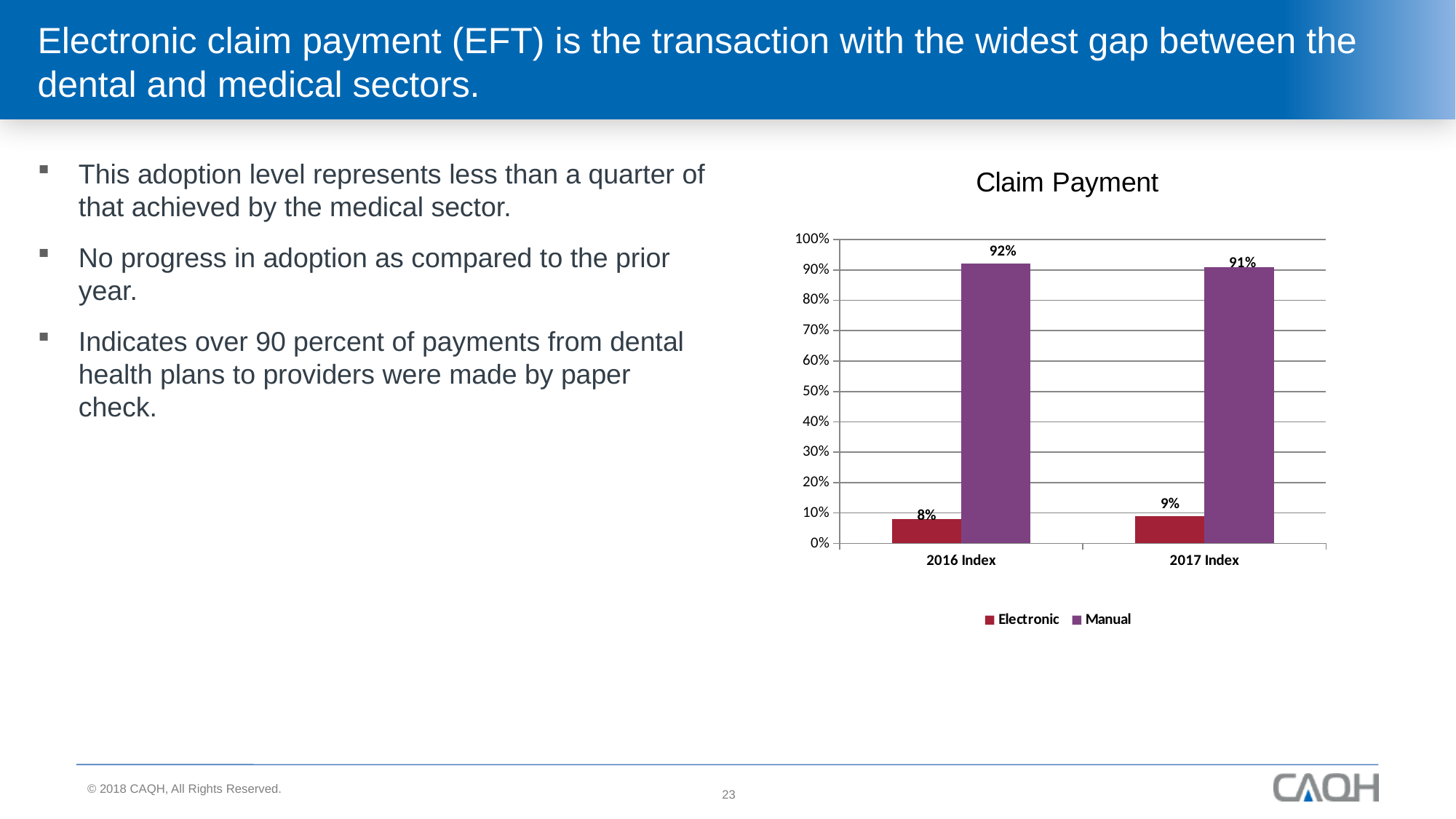
What is the Electronic value for the 2017 Index? 9% Does the Electronic series rise or fall from the 2016 Index to the 2017 Index? Rise How many categories are shown on the x axis? 2 What is the difference between the Manual and Electronic values for the 2016 Index? 84% What is the title of the chart? Claim Payment What is the Electronic value for the 2016 Index? 8% How many series does the legend list? 2 Which series has the higher value for the 2017 Index, Electronic or Manual? Manual What is the Manual value for the 2017 Index? 91% What is the Manual value for the 2016 Index? 92% What is the difference between the Electronic values for the 2017 Index and the 2016 Index? 1% What kind of chart is shown on the slide? Bar chart